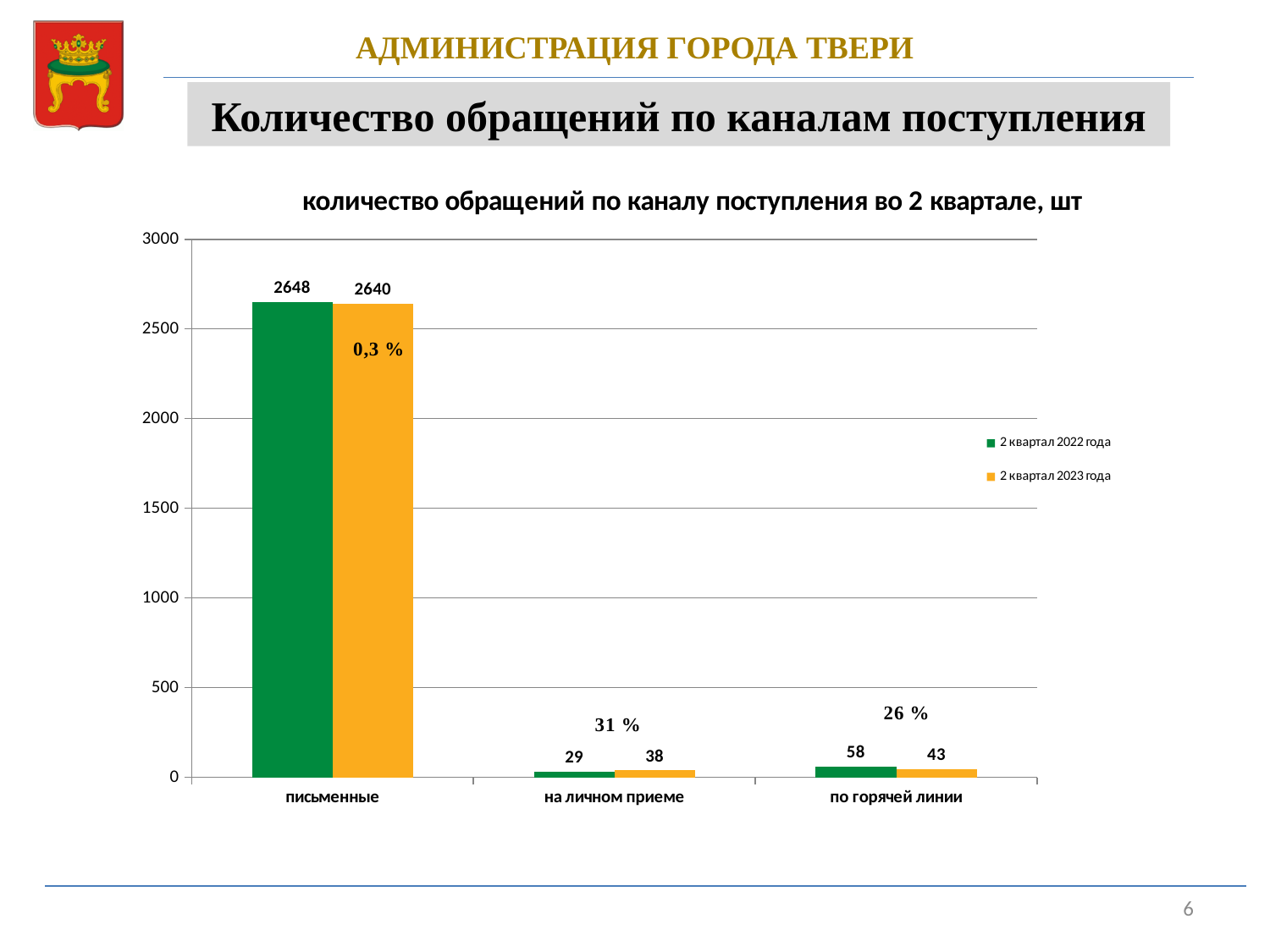
Which is larger for на личном приеме: 2 квартал 2022 года or 2 квартал 2023 года? 2 квартал 2023 года How many categories are shown on the x axis? 3 What is the value for письменные in 2 квартал 2022 года? 2648 What is the difference between the 2 квартал 2022 года and 2 квартал 2023 года values for по горячей линии? 15 What is the value for по горячей линии in 2 квартал 2022 года? 58 Which category has the lowest value in 2 квартал 2022 года? на личном приеме What is the value for письменные in 2 квартал 2023 года? 2640 Is the value for письменные in 2 квартал 2022 года greater or less than 2500? greater Which category has the highest value in 2 квартал 2023 года? письменные How many series does the legend list? 2 What is the value for на личном приеме in 2 квартал 2023 года? 38 What kind of chart is shown on the slide? bar chart